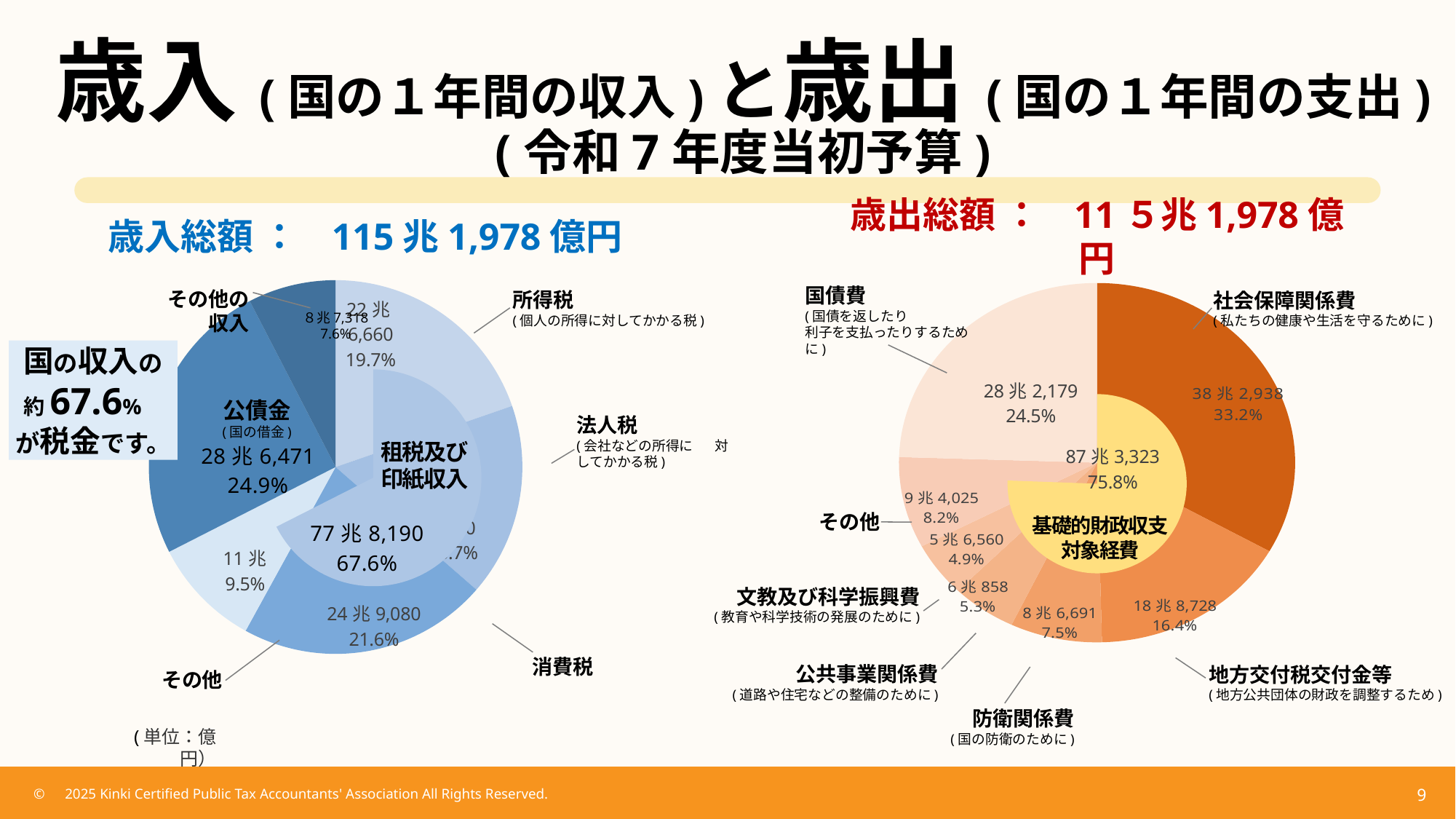
In the 歳入 chart on the left, which has the larger share, 消費税 or 所得税? 消費税 In the 歳出 chart on the right, which outer category has the smallest share? 文教及び科学振興費 How many outer categories are shown in the 歳出 chart on the right? 7 In the 歳出 (expenditure) chart on the right, what is the value shown for 社会保障関係費? 38兆2,938 What is the 歳入総額 (total revenue) stated above the left chart? 115兆1,978億円 In the 歳入 chart on the left, what share does 租税及び印紙収入 account for? 67.6% In the 歳入 (revenue) chart on the left, what share does 所得税 account for? 19.7% In the 歳出 chart on the right, which outer category has the largest share? 社会保障関係費 In the 歳出 chart on the right, what share does 防衛関係費 account for? 7.5% In the 歳入 chart on the left, what share does 公債金 account for? 24.9% In the 歳出 chart on the right, what is the difference in percentage points between the share of 社会保障関係費 and the share of 国債費? 8.7 percentage points What type of chart is the 歳出 chart on the right? Doughnut (pie) chart